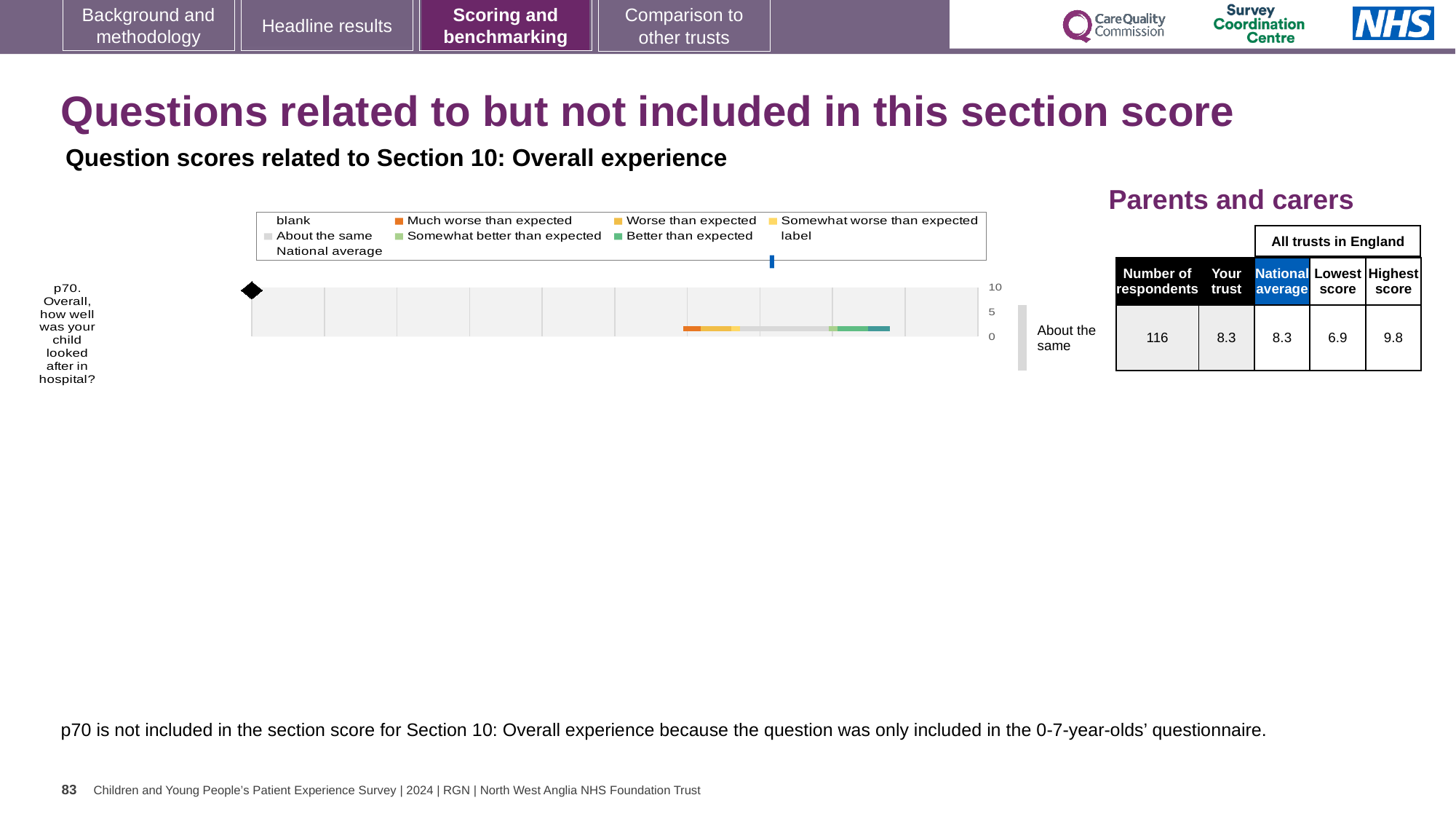
How many questions are plotted in the chart? 1 Is the 'Your trust' score for p70 larger or smaller than the national average? They are equal (8.3) Which benchmark category label is shown to the right of the p70 bar? About the same According to the table next to the chart, what is the 'Your trust' score for p70? 8.3 Which legend entry is shown in orange? Much worse than expected According to the table next to the chart, what is the lowest score among all trusts in England for p70? 6.9 What is the highest value shown on the chart's axis? 10 What kind of chart is used to show the p70 question score? bar chart What is the difference between the highest and lowest trust scores for p70 shown in the table next to the chart? 2.9 According to the table next to the chart, what is the highest score among all trusts in England for p70? 9.8 How many respondents answered p70 according to the table next to the chart? 116 According to the table next to the chart, what is the national average score for p70? 8.3